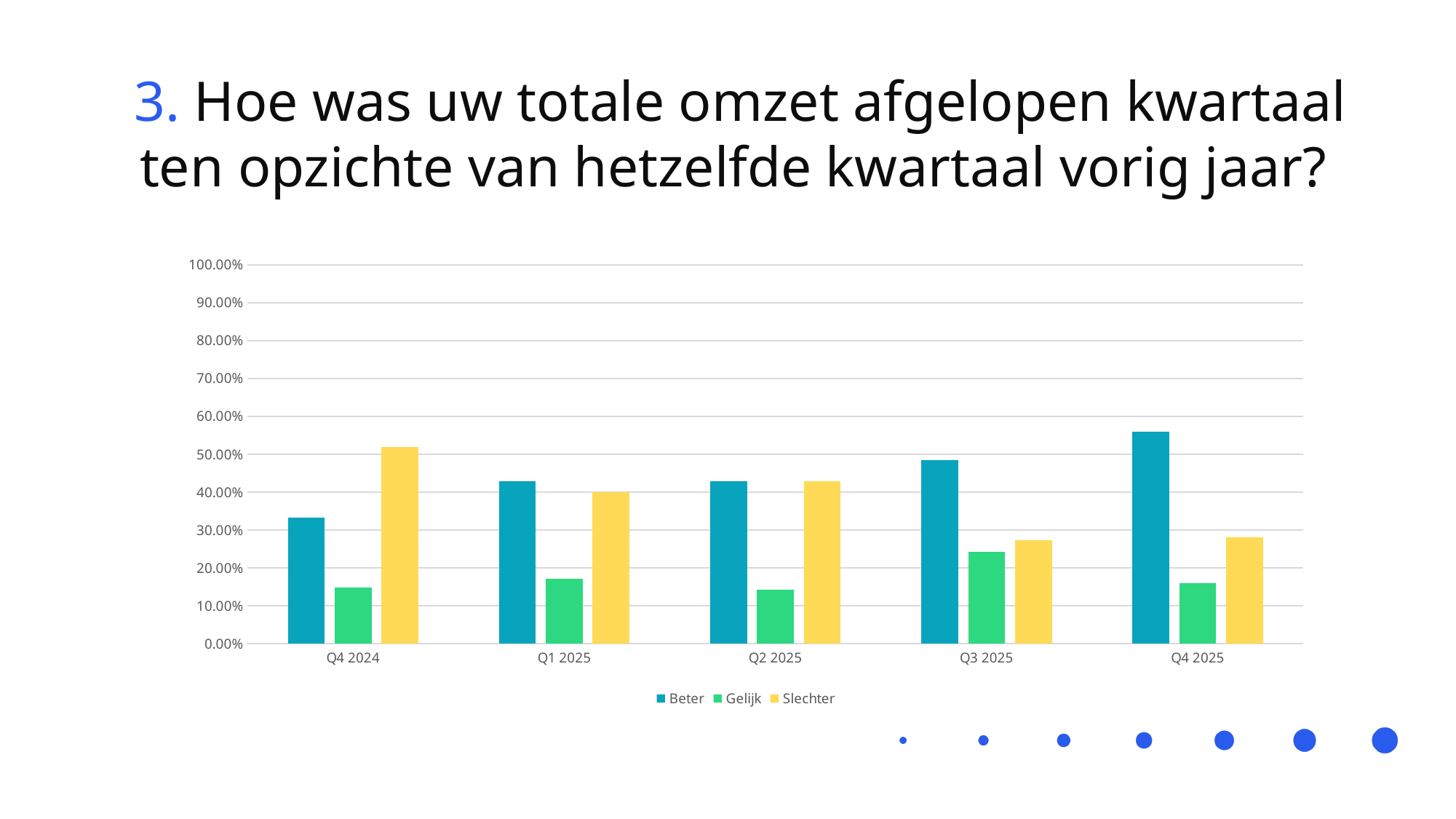
How many quarters are shown on the x axis of the chart? 5 In Q4 2024, which is larger: Beter or Slechter? Slechter In which quarter is the value for Beter the highest? Q4 2025 What kind of chart is shown on the slide? bar chart Is the value for Beter in Q4 2025 greater or less than 50%? greater In which quarter is the value for Beter the lowest? Q4 2024 In Q4 2025, which is larger: Beter or Slechter? Beter What are the three series listed in the chart's legend? Beter, Gelijk, Slechter Does the value for Beter rise or fall from Q4 2024 to Q4 2025? rise Is the value for Gelijk in Q2 2025 greater or less than 20%? less Is the value for Slechter in Q4 2024 greater or less than 50%? greater How many series does the chart's legend list? 3